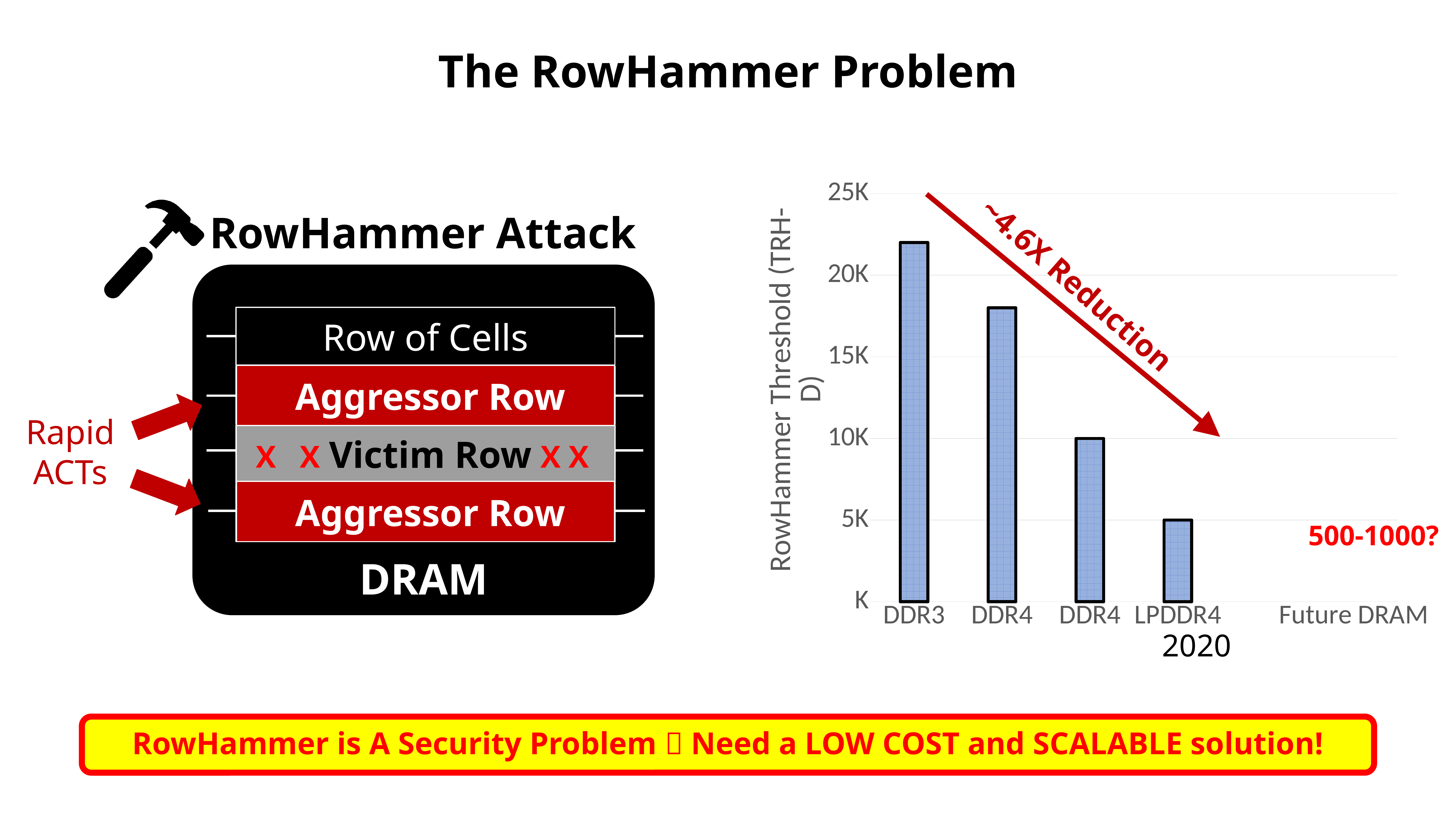
Which has a larger RowHammer Threshold, DDR3 or LPDDR4? DDR3 What reduction factor is annotated by the red arrow on the chart? ~4.6X Reduction What value is annotated in red for Future DRAM on the chart? 500-1000? Is the RowHammer Threshold for the first DDR4 bar (second bar from the left) greater or less than 20K? less Which plotted bar has the lowest RowHammer Threshold? LPDDR4 Which category has the highest RowHammer Threshold bar? DDR3 Is the RowHammer Threshold for DDR3 greater or less than 20K? greater What kind of chart is shown on the right side of the slide? bar chart What is the RowHammer Threshold value for LPDDR4? 5K How many bars are plotted in the RowHammer Threshold chart? 4 Do the RowHammer Threshold values rise or fall from DDR3 to LPDDR4 along the x axis? fall What is the RowHammer Threshold value for the second DDR4 bar (third bar from the left)? 10K